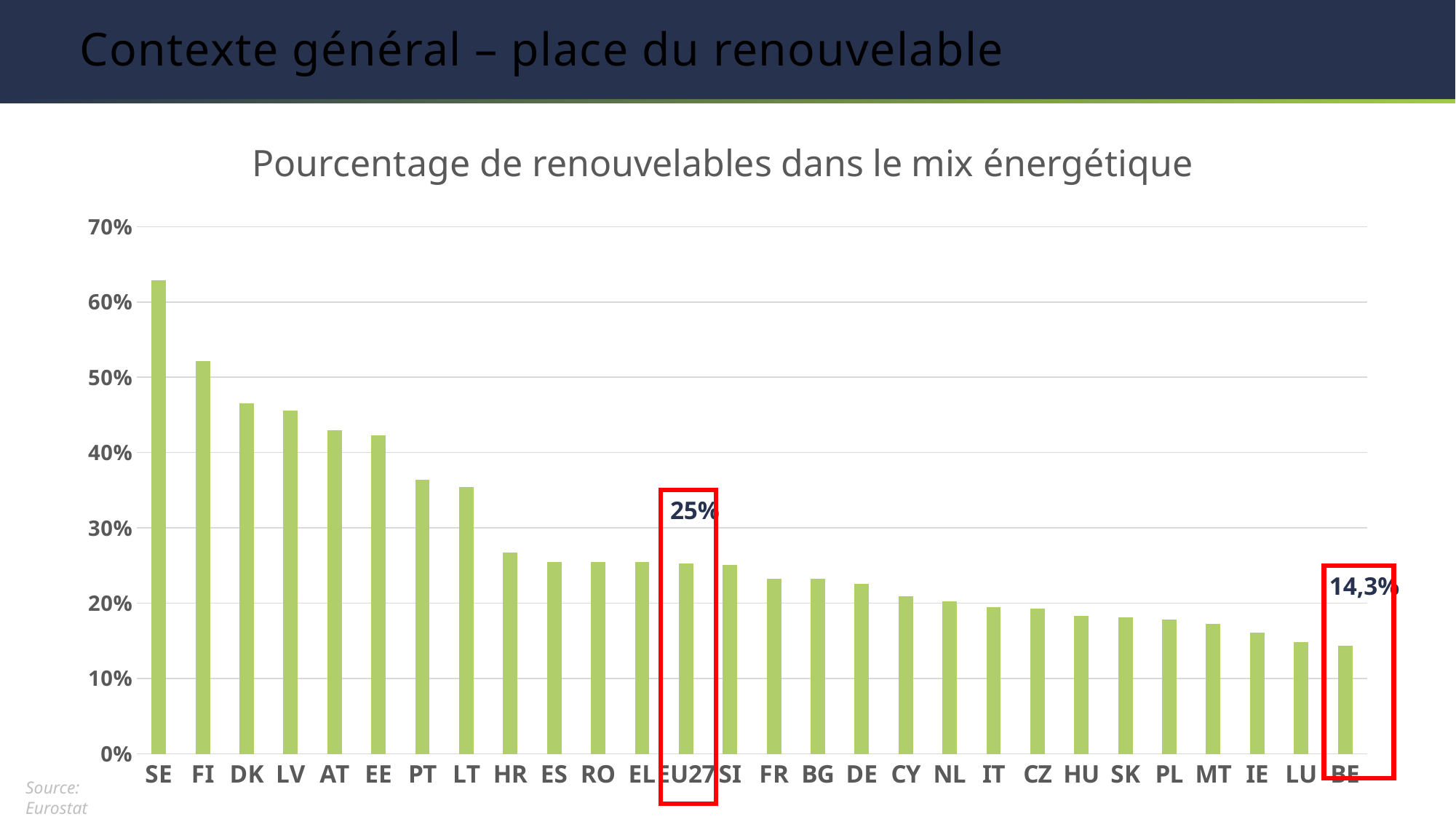
What is the difference between the EU27 value and the BE value? 10,7% Is the value for SE greater or less than 60%? greater What is the value shown for EU27? 25% Which country has the highest percentage of renewables in the energy mix? SE How many categories (bars) are shown on the chart? 28 Do the values rise or fall from left to right along the x axis? Fall Which category has the lowest value on the chart? BE Is the value for LU greater or less than 20%? less Is the value for DK greater or less than 50%? less What kind of chart is shown on the slide? Bar chart Which has a larger value, SE or FI? SE What is the value shown for BE? 14,3%